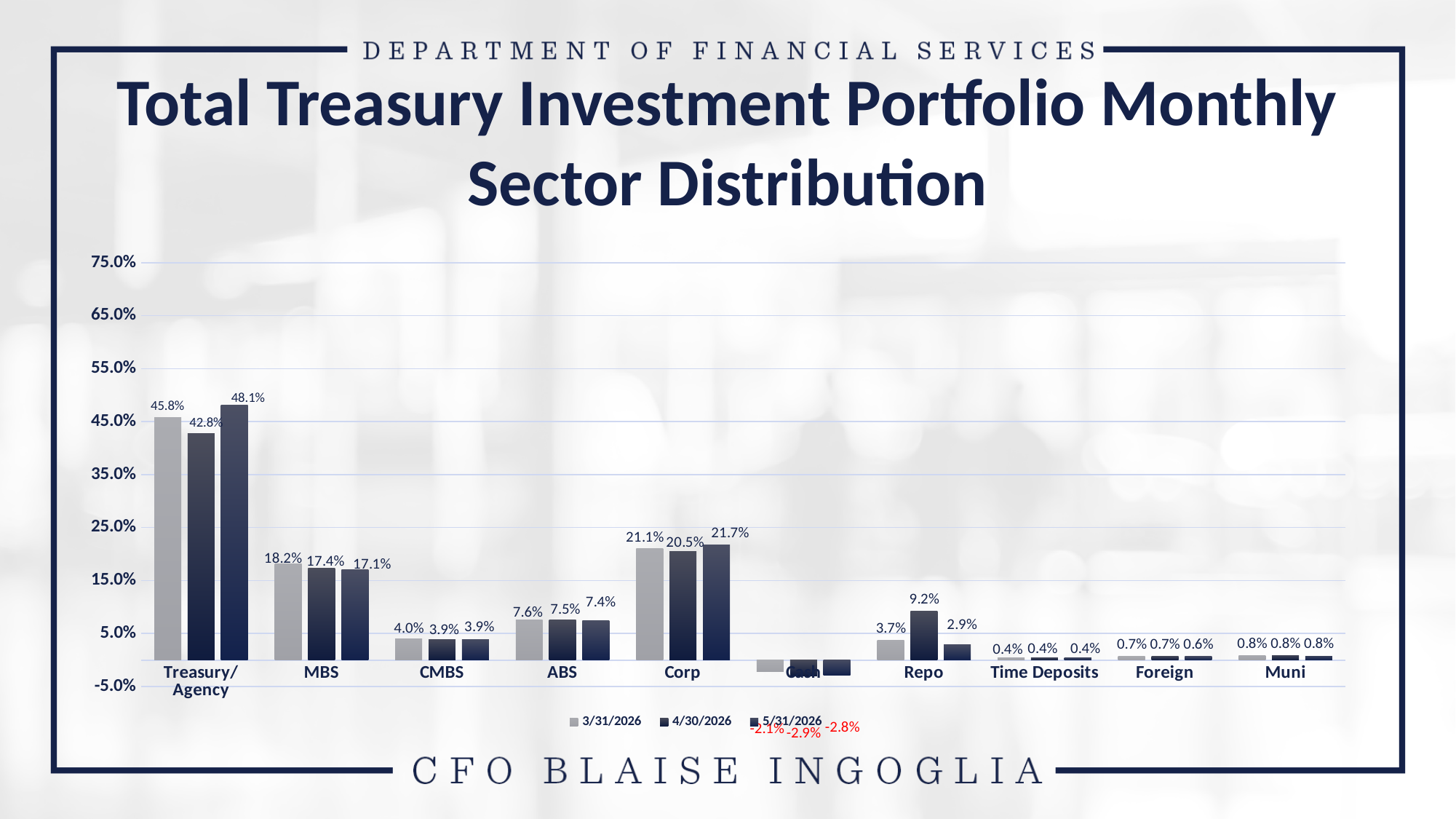
What is the difference between the 5/31/2026 and 4/30/2026 values for Treasury/Agency? 5.3% What is the value for Treasury/Agency in the 5/31/2026 series? 48.1% Which is larger for Repo: the 3/31/2026 value or the 4/30/2026 value? 4/30/2026 What is the value for Repo in the 4/30/2026 series? 9.2% What is the value for MBS in the 5/31/2026 series? 17.1% What kind of chart is shown on the slide? Bar chart How many sectors are shown on the x axis? 10 How many series does the legend list? 3 Which sector has the lowest value in the 4/30/2026 series? Cash Which sector has the highest value in the 5/31/2026 series? Treasury/Agency What is the value for Corp in the 3/31/2026 series? 21.1% Do the MBS values rise or fall from 3/31/2026 to 5/31/2026? Fall